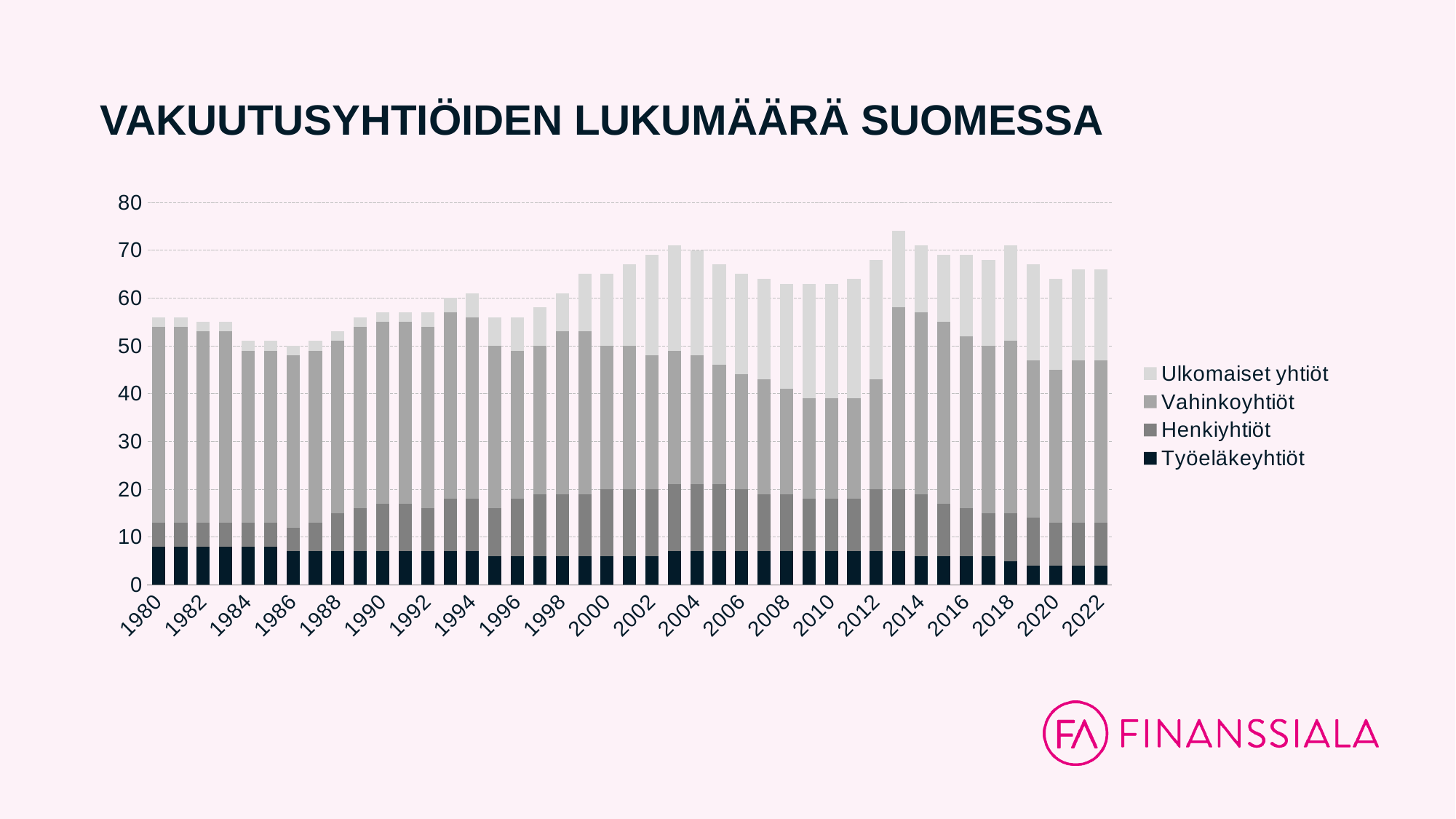
Which year has the highest total number of companies? 2013 Is the value for Työeläkeyhtiöt in 2022 greater or less than 10? less Which series is shown in the darkest colour at the bottom of each bar? Työeläkeyhtiöt Is the total for 2013 larger or smaller than the total for 2020? larger Is the total for 2013 greater or less than 70? greater What is the title of the chart? VAKUUTUSYHTIÖIDEN LUKUMÄÄRÄ SUOMESSA What kind of chart is shown on the slide? stacked bar chart Do the total bar heights rise or fall from 2013 to 2020? fall Is the total for 2000 greater or less than 60? greater Do the total bar heights rise or fall from 1986 to 2003? rise How many series does the legend list? 4